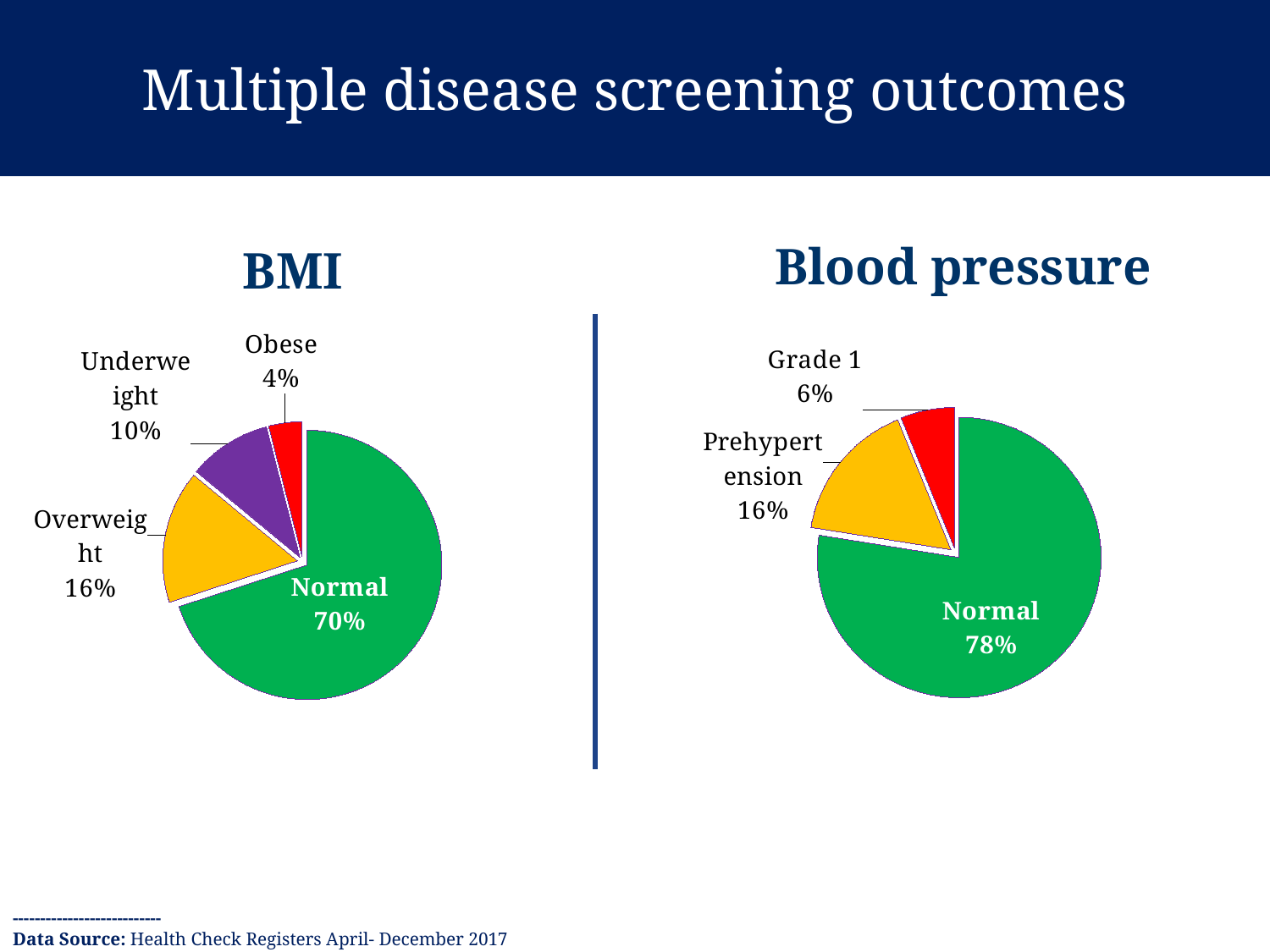
What type of chart is the Blood pressure chart? Pie chart How many categories does the BMI chart show? 4 In the BMI chart, what is the difference in percentage points between Overweight and Underweight? 6 In the BMI chart, which category has the smallest share? Obese In the Blood pressure chart, which category has the smallest share? Grade 1 In the Blood pressure chart, what is the difference in percentage points between Normal and Prehypertension? 62 In the Blood pressure chart, what percentage of people are Grade 1? 6% Which is larger: the Normal share in the BMI chart or the Normal share in the Blood pressure chart? Blood pressure In the BMI chart, which category has the largest share? Normal In the Blood pressure chart, what percentage of people have Prehypertension? 16% In the BMI chart, what percentage of people are classified as Normal? 70% In the BMI chart, what percentage of people are Obese? 4%